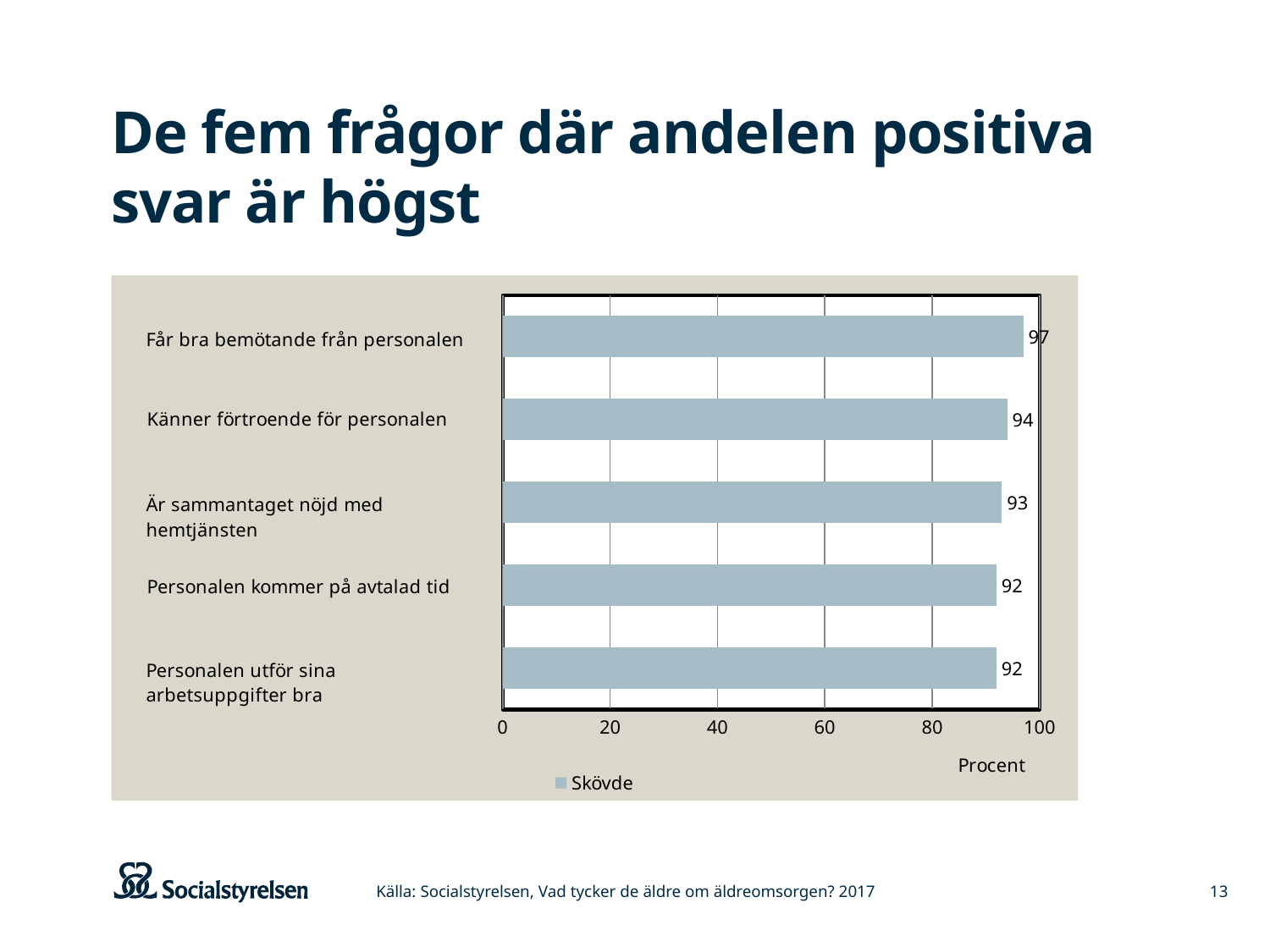
What is the value for "Är sammantaget nöjd med hemtjänsten"? 93 How many series does the legend list? 1 How many categories are shown in the chart? 5 What is the difference between the values for "Känner förtroende för personalen" and "Personalen utför sina arbetsuppgifter bra"? 2 What series name is shown in the legend? Skövde Which is larger, the value for "Får bra bemötande från personalen" or the value for "Är sammantaget nöjd med hemtjänsten"? Får bra bemötande från personalen What is the value for "Får bra bemötande från personalen"? 97 What is the value for "Känner förtroende för personalen"? 94 Which category has the highest value? Får bra bemötande från personalen What is the difference between the values for "Får bra bemötande från personalen" and "Känner förtroende för personalen"? 3 What is the value for "Personalen kommer på avtalad tid"? 92 What kind of chart is shown on the slide? Bar chart